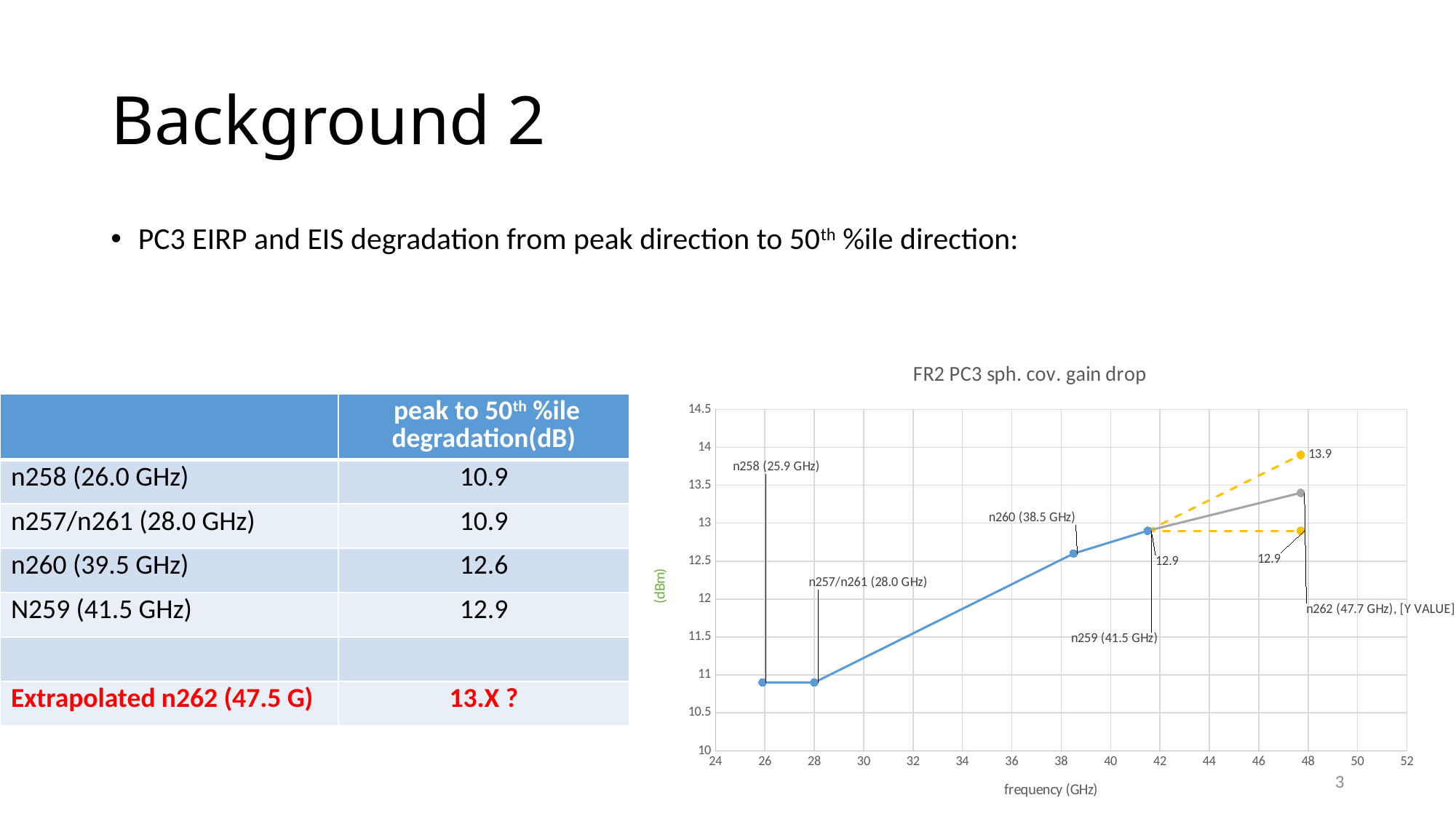
What value is labelled at the n259 (41.5 GHz) point on the chart? 12.9 Which has the larger value, n260 (38.5 GHz) or n259 (41.5 GHz)? n259 (41.5 GHz) What value is labelled at the end of the upper dashed line at 47.7 GHz? 13.9 Do the values rise or fall along the x axis from 28 GHz to 41.5 GHz? rise What kind of chart is shown on the slide? line chart How many band points are labelled on the chart? 5 What is the difference between the two labelled values at 47.7 GHz (13.9 and 12.9)? 1.0 What is the label of the x axis of the chart? frequency (GHz) What is the title of the chart? FR2 PC3 sph. cov. gain drop What value is labelled at the end of the lower dashed line at 47.7 GHz? 12.9 Is the value for n260 (38.5 GHz) greater or less than 12? greater Is the value for n258 (25.9 GHz) greater or less than 12? less